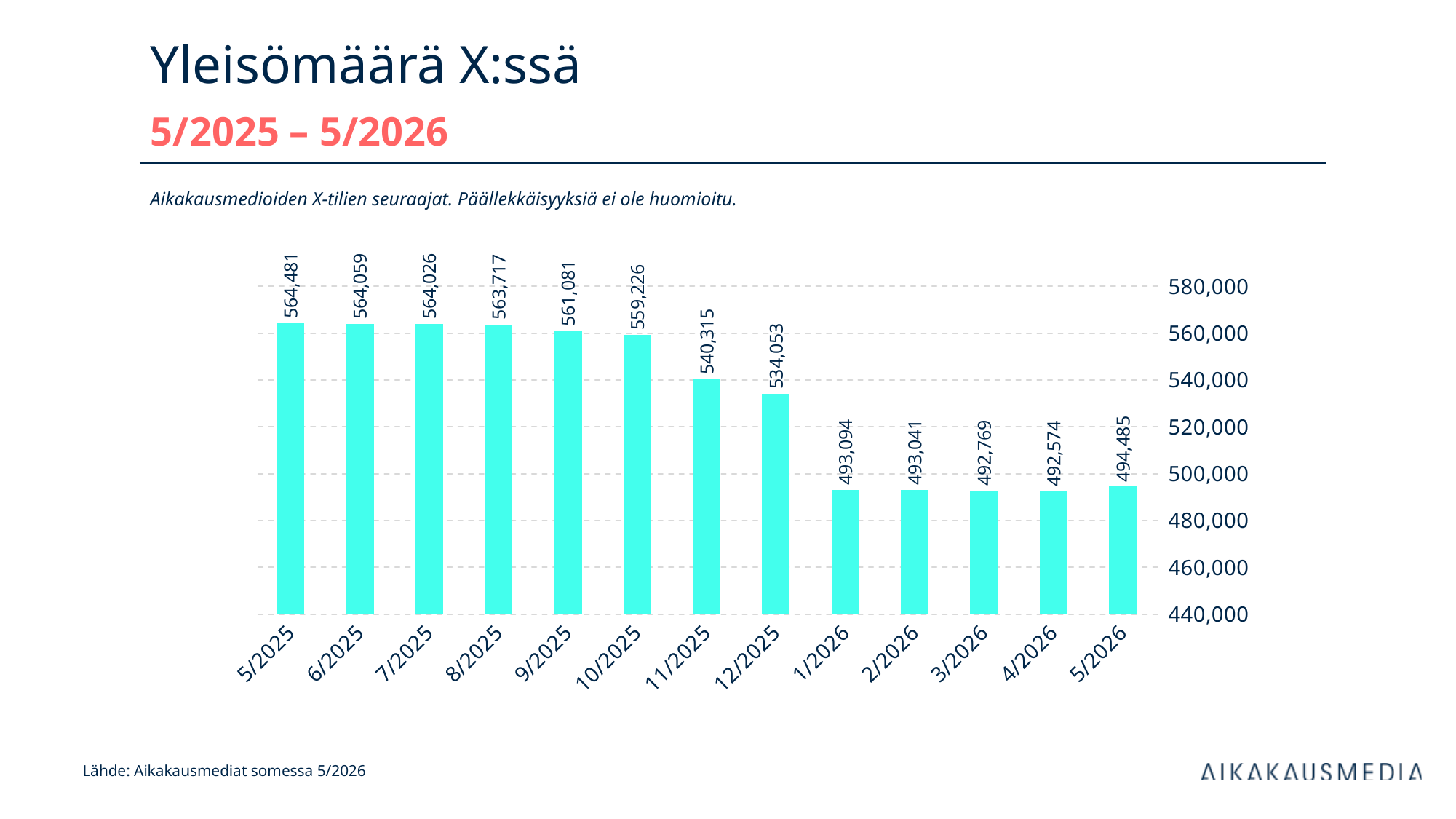
What is the value for 5/2026? 494,485 Is the value for 1/2026 greater or less than 500,000? less What is the value for 5/2025? 564,481 What is the value for 12/2025? 534,053 How many months are shown on the x axis? 13 What kind of chart is shown on the slide? bar chart Which is larger, the value for 10/2025 or the value for 11/2025? 10/2025 What is the difference between the values for 11/2025 and 12/2025? 6,262 Which month has the highest value? 5/2025 Which month has the lowest value? 4/2026 Do the values generally rise or fall from 5/2025 to 5/2026? fall What is the difference between the values for 5/2025 and 5/2026? 69,996